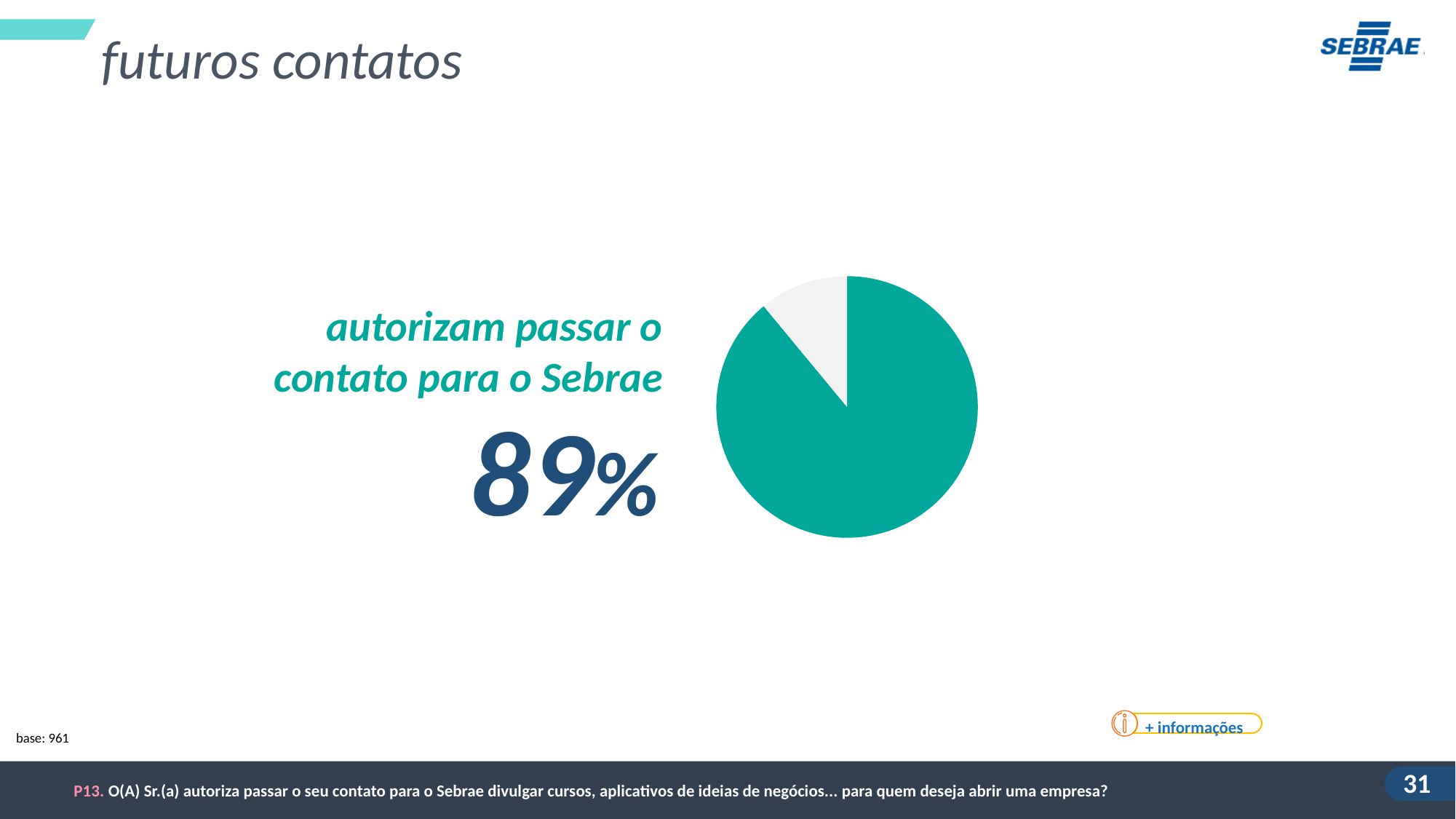
Which slice takes up the largest share of the pie chart? the teal slice (authorize passing contact to Sebrae) What percentage of respondents authorize passing their contact to Sebrae? 89% What is the base (number of respondents) shown for the chart? 961 Which slice of the pie chart is larger, the teal one or the light grey one? the teal one What share of the pie does the light grey slice represent? 11% What kind of chart is shown on the slide? pie chart What is the title of the slide containing the pie chart? futuros contatos How many slices does the pie chart have? 2